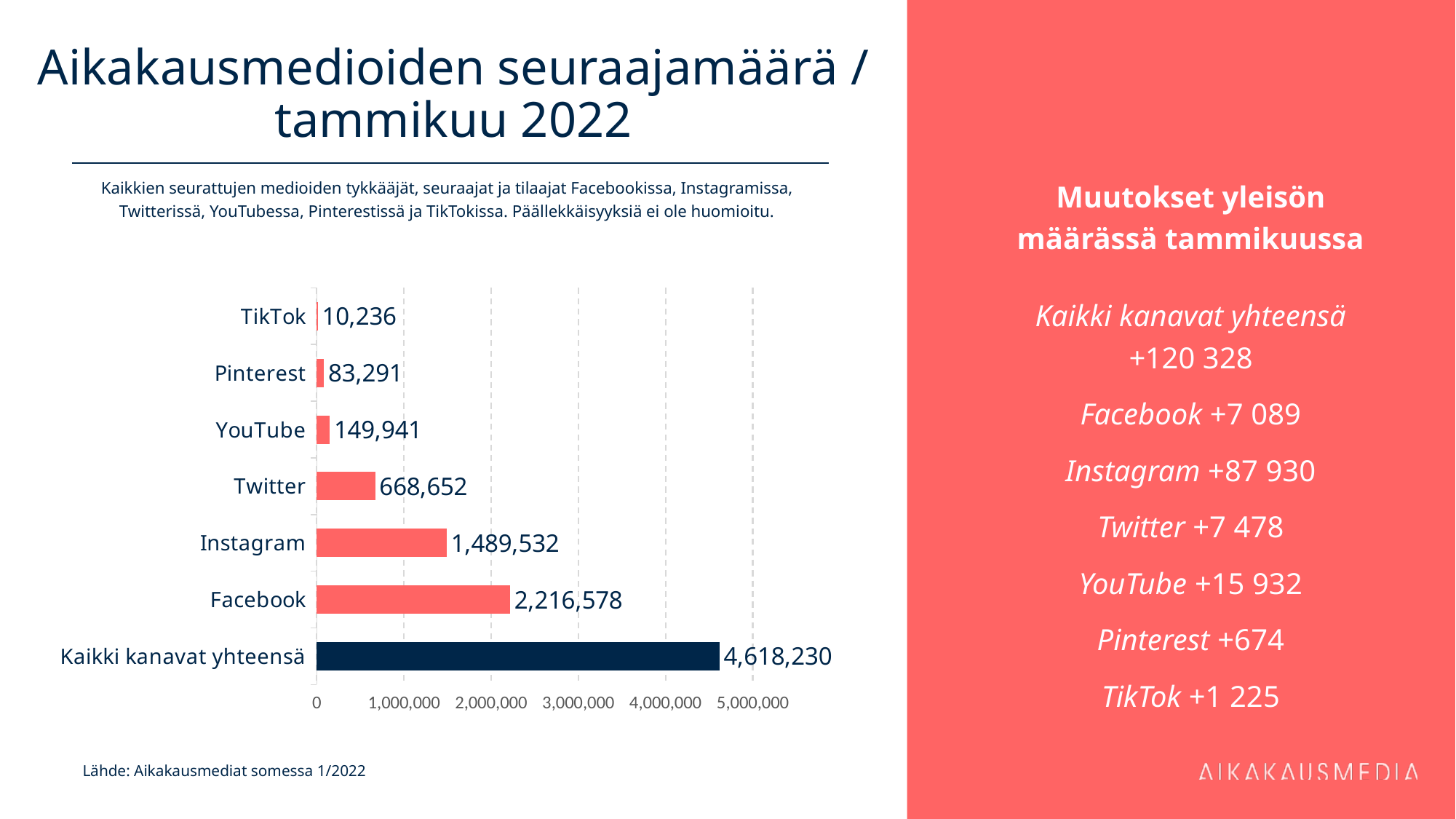
What is the difference between the values for Twitter and YouTube? 518,711 What kind of chart is shown on the slide? Bar chart Is the value for Facebook greater or less than 2,000,000? greater Which is larger, the value for Pinterest or the value for YouTube? YouTube How many categories (bars) are shown in the chart? 7 What is the value for Kaikki kanavat yhteensä in the chart? 4,618,230 What is the value for TikTok in the chart? 10,236 What is the value for Instagram in the chart? 1,489,532 What is the value for Facebook in the chart? 2,216,578 What is the difference between the values for Facebook and Instagram? 727,046 Which category has the lowest value in the chart? TikTok Excluding the total bar (Kaikki kanavat yhteensä), which channel has the highest value? Facebook